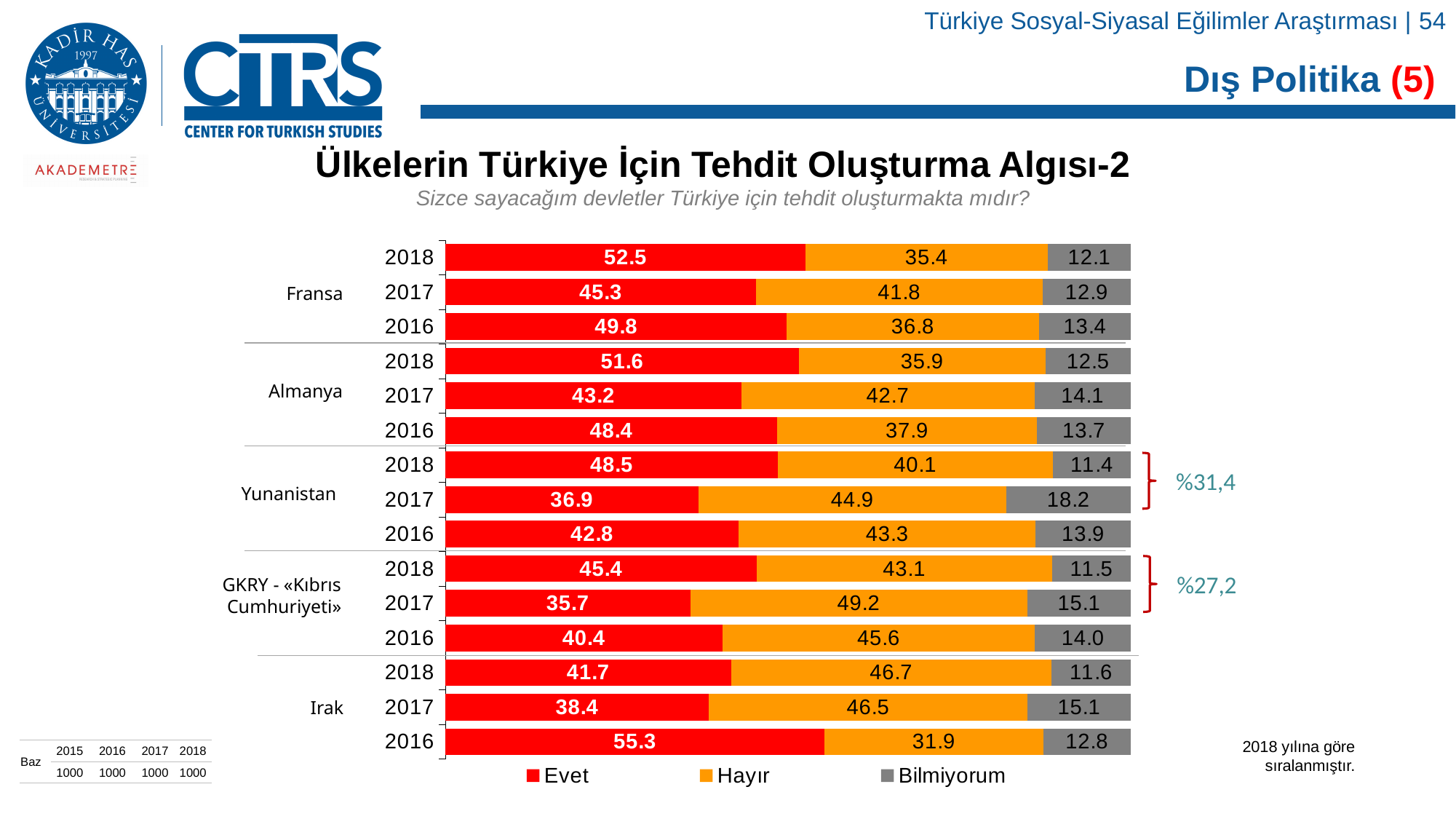
What is the total of the three segments for Yunanistan in 2018? 100.0 What is the "Hayır" value for GKRY - «Kıbrıs Cumhuriyeti» in 2017? 49.2 How many bars (country-year combinations) are shown in the chart? 15 Which country and year has the lowest "Evet" value in the chart? GKRY - «Kıbrıs Cumhuriyeti» 2017 How many series does the legend list? 3 What is the "Bilmiyorum" value for Yunanistan in 2017? 18.2 How does the "Bilmiyorum" value for Fransa change from 2016 to 2018? It falls What percentage of respondents answered "Evet" for Fransa in 2018? 52.5 What type of chart is shown on the slide? Stacked bar chart Which country and year has the highest "Evet" value in the chart? Irak 2016 What is the difference between the "Evet" values for Almanya in 2018 and 2017? 8.4 Which is larger for Irak in 2018: the "Evet" value or the "Hayır" value? Hayır